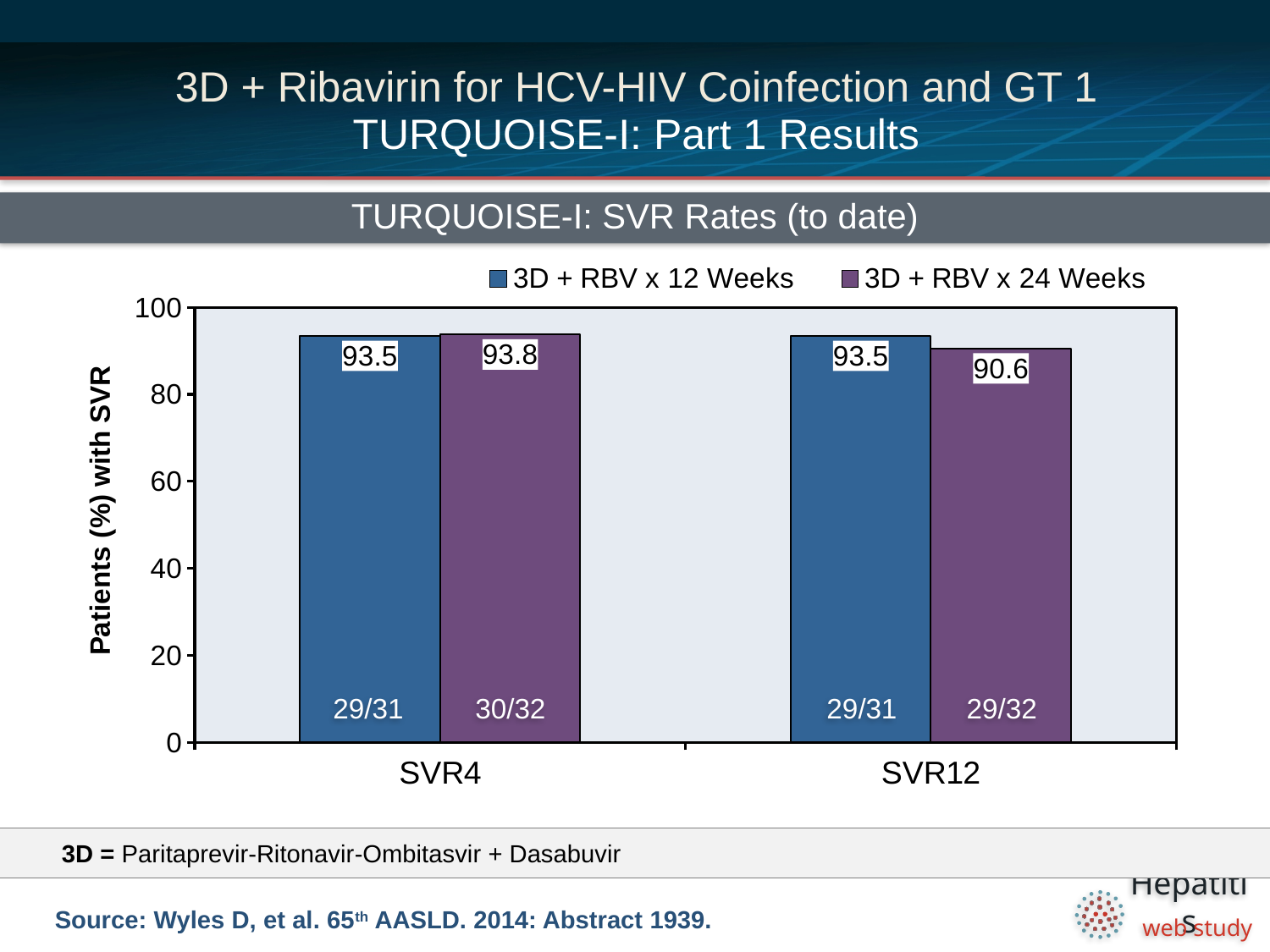
Which bar shows the lowest SVR rate on the chart? 3D + RBV x 24 Weeks at SVR12 What is the SVR12 rate for the 3D + RBV x 12 Weeks group? 93.5 What is the SVR12 rate for the 3D + RBV x 24 Weeks group? 90.6 How many patients achieved SVR12 in the 3D + RBV x 24 Weeks group, as shown on the bar? 29/32 What kind of chart is shown on the slide? Bar chart What is the SVR4 rate for the 3D + RBV x 12 Weeks group? 93.5 How many series does the legend list? 2 At SVR4, which group has the higher rate: 3D + RBV x 12 Weeks or 3D + RBV x 24 Weeks? 3D + RBV x 24 Weeks What is the difference between the SVR12 rates of the 12-week and 24-week groups? 2.9 What is the SVR4 rate for the 3D + RBV x 24 Weeks group? 93.8 What is the label of the y axis? Patients (%) with SVR How many categories are shown on the x axis? 2